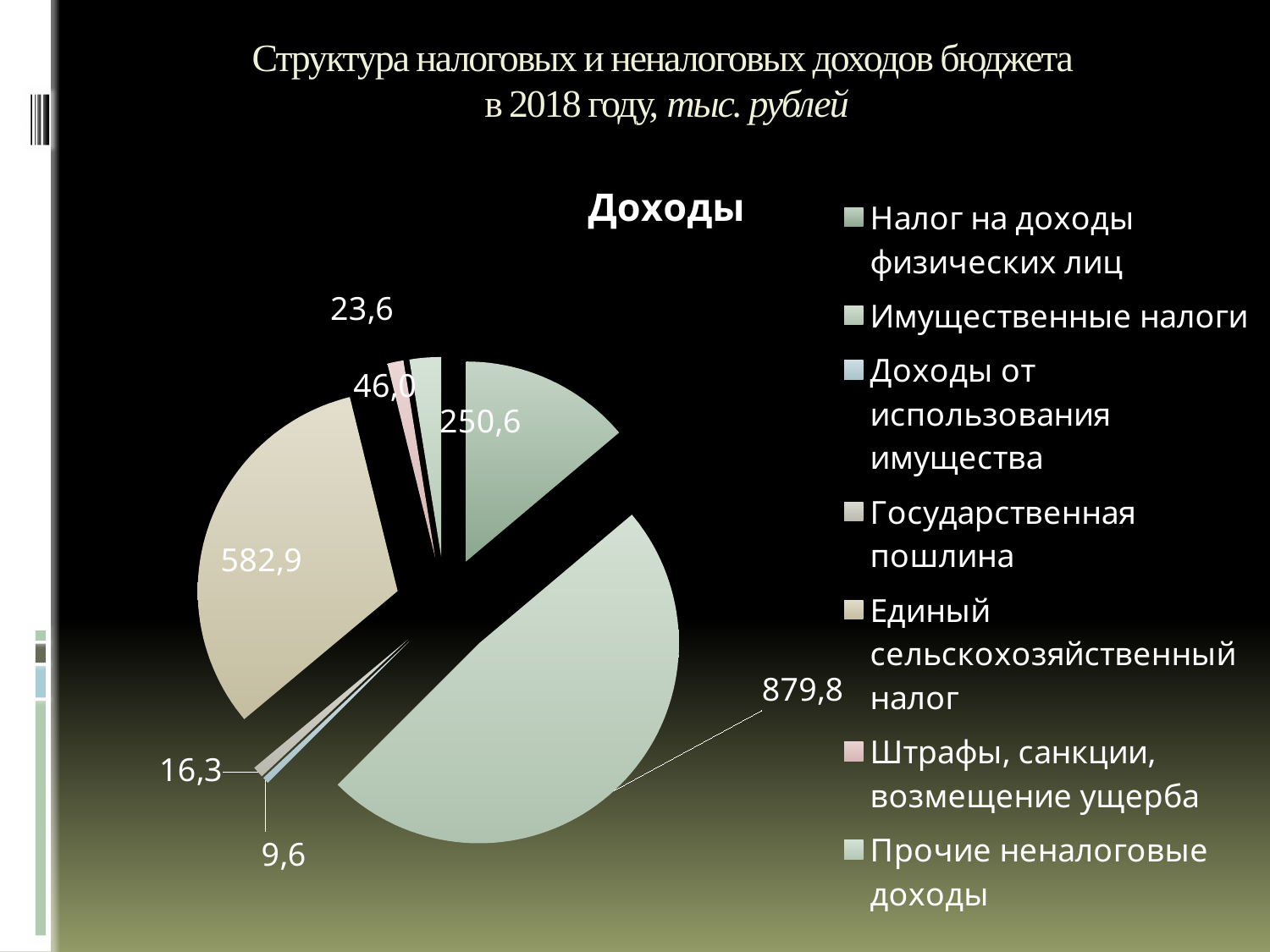
What is the value for Штрафы, санкции, возмещение ущерба? 23,6 What kind of chart is shown on the slide? pie chart Which category has the largest slice of the pie? Имущественные налоги Which category has the smallest slice of the pie? Доходы от использования имущества What is the value for Имущественные налоги? 879,8 What is the difference between Имущественные налоги and Единый сельскохозяйственный налог? 296,9 How many categories does the legend list? 7 Which is larger: Государственная пошлина or Прочие неналоговые доходы? Прочие неналоговые доходы What is the value for Налог на доходы физических лиц? 250,6 What is the value for Единый сельскохозяйственный налог? 582,9 What is the value for Доходы от использования имущества? 9,6 What is the title of the pie chart? Доходы